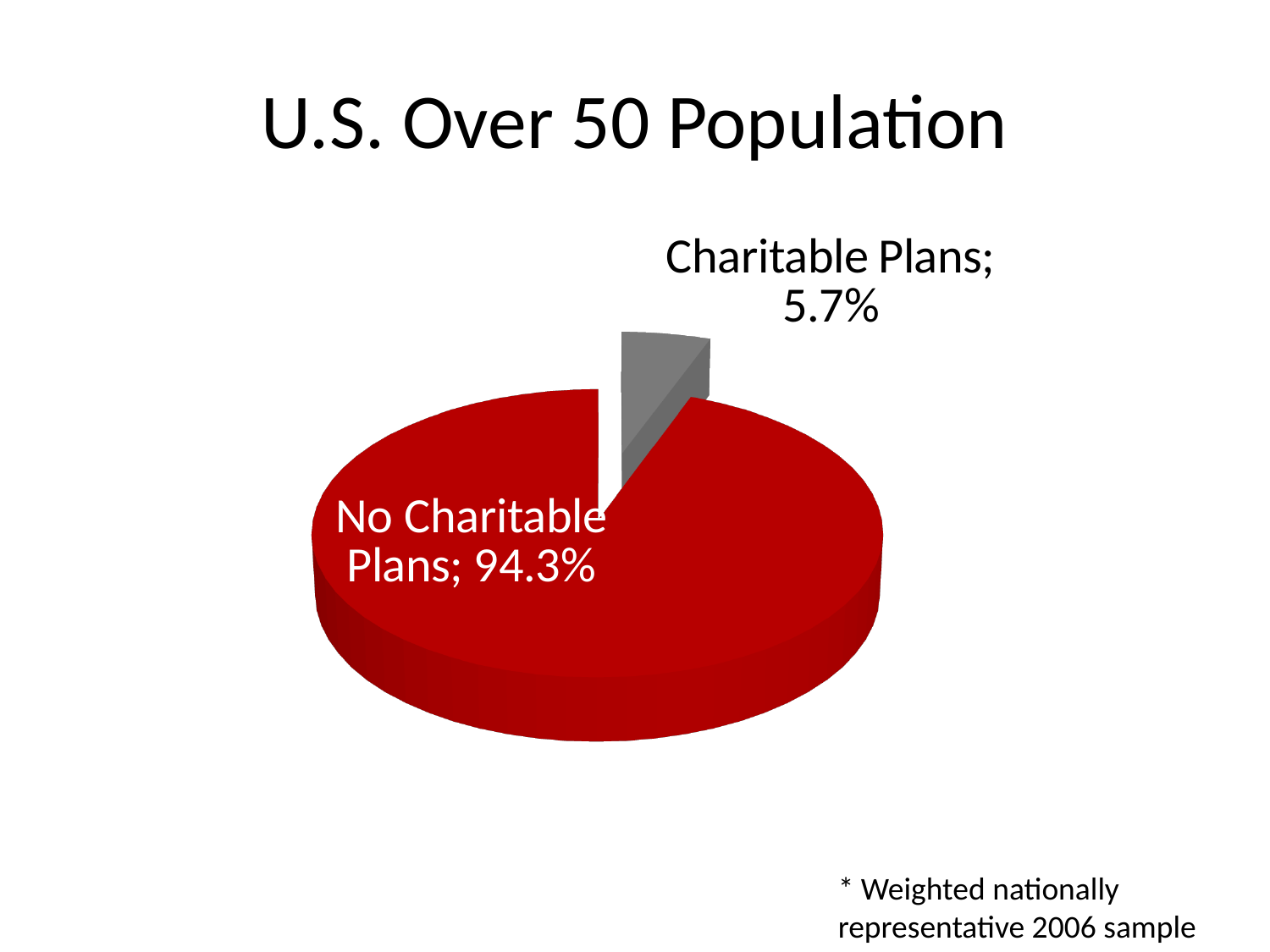
What percentage of the pie is labelled Charitable Plans? 5.7% Which slice of the pie is the largest? No Charitable Plans What percentage of the pie is labelled No Charitable Plans? 94.3% What colour is the Charitable Plans slice? grey Which is larger, the Charitable Plans slice or the No Charitable Plans slice? No Charitable Plans How many slices does the pie chart have? 2 What share of the pie does the Charitable Plans slice represent? 5.7% What kind of chart is shown on the slide? pie chart Which slice of the pie is the smallest? Charitable Plans What is the title of the chart? U.S. Over 50 Population What is the difference in percentage points between the No Charitable Plans slice and the Charitable Plans slice? 88.6